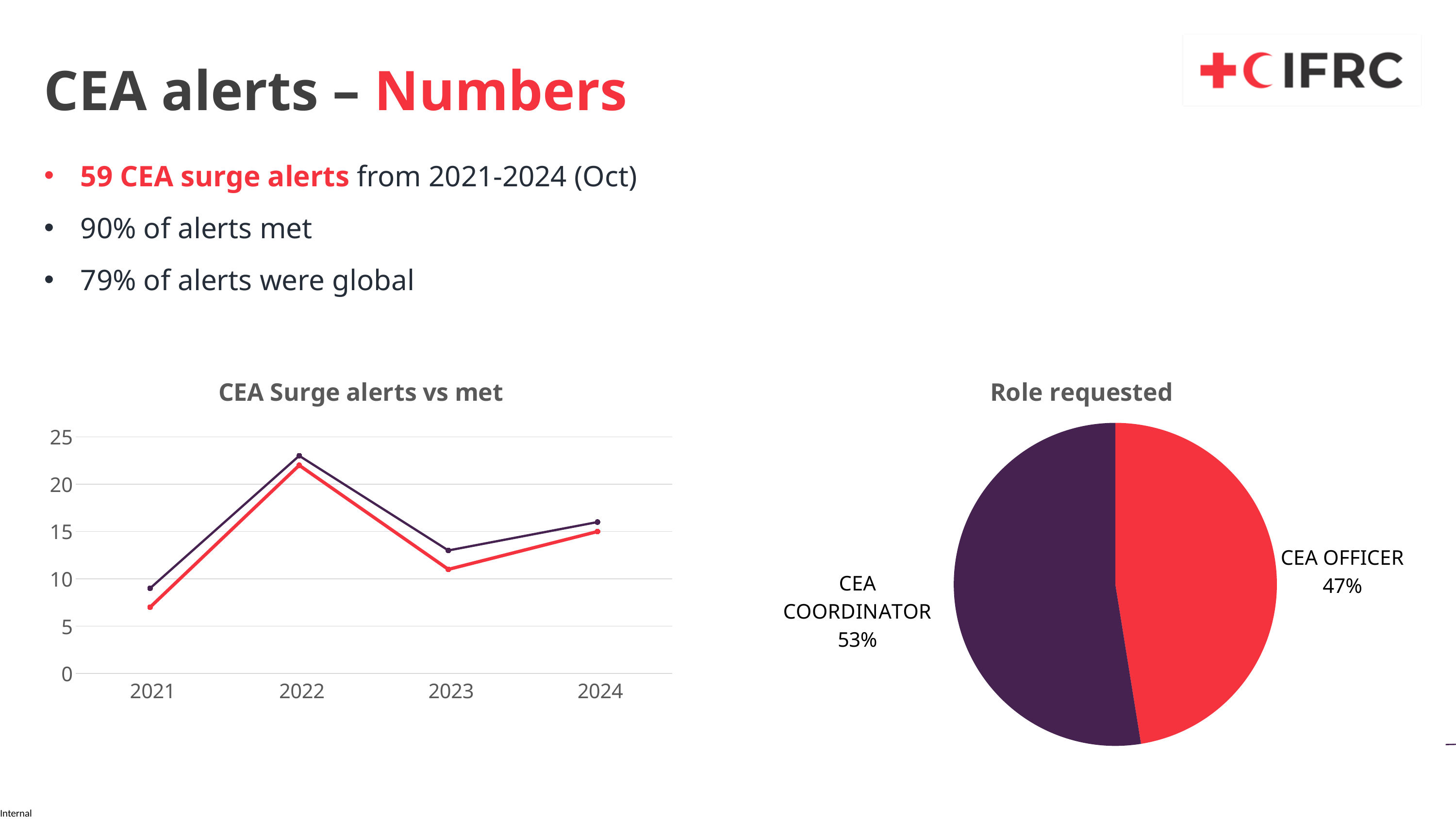
In the 'Role requested' chart, what share is CEA COORDINATOR? 53% What kind of chart is the 'CEA Surge alerts vs met' chart? line chart In the 'CEA Surge alerts vs met' chart, do the values rise or fall from 2021 to 2022? rise In the 'Role requested' chart, which role has the larger share? CEA COORDINATOR In the 'CEA Surge alerts vs met' chart, do the values rise or fall from 2022 to 2023? fall In the 'CEA Surge alerts vs met' chart, how many years are shown on the x axis? 4 In the 'CEA Surge alerts vs met' chart, which year has the highest values? 2022 In the 'CEA Surge alerts vs met' chart, which year has the lowest values? 2021 What kind of chart is the 'Role requested' chart? pie chart In the 'Role requested' chart, what share is CEA OFFICER? 47% In the 'CEA Surge alerts vs met' chart, are the values for 2022 greater or less than 20? greater In the 'CEA Surge alerts vs met' chart, are the values for 2021 greater or less than 10? less